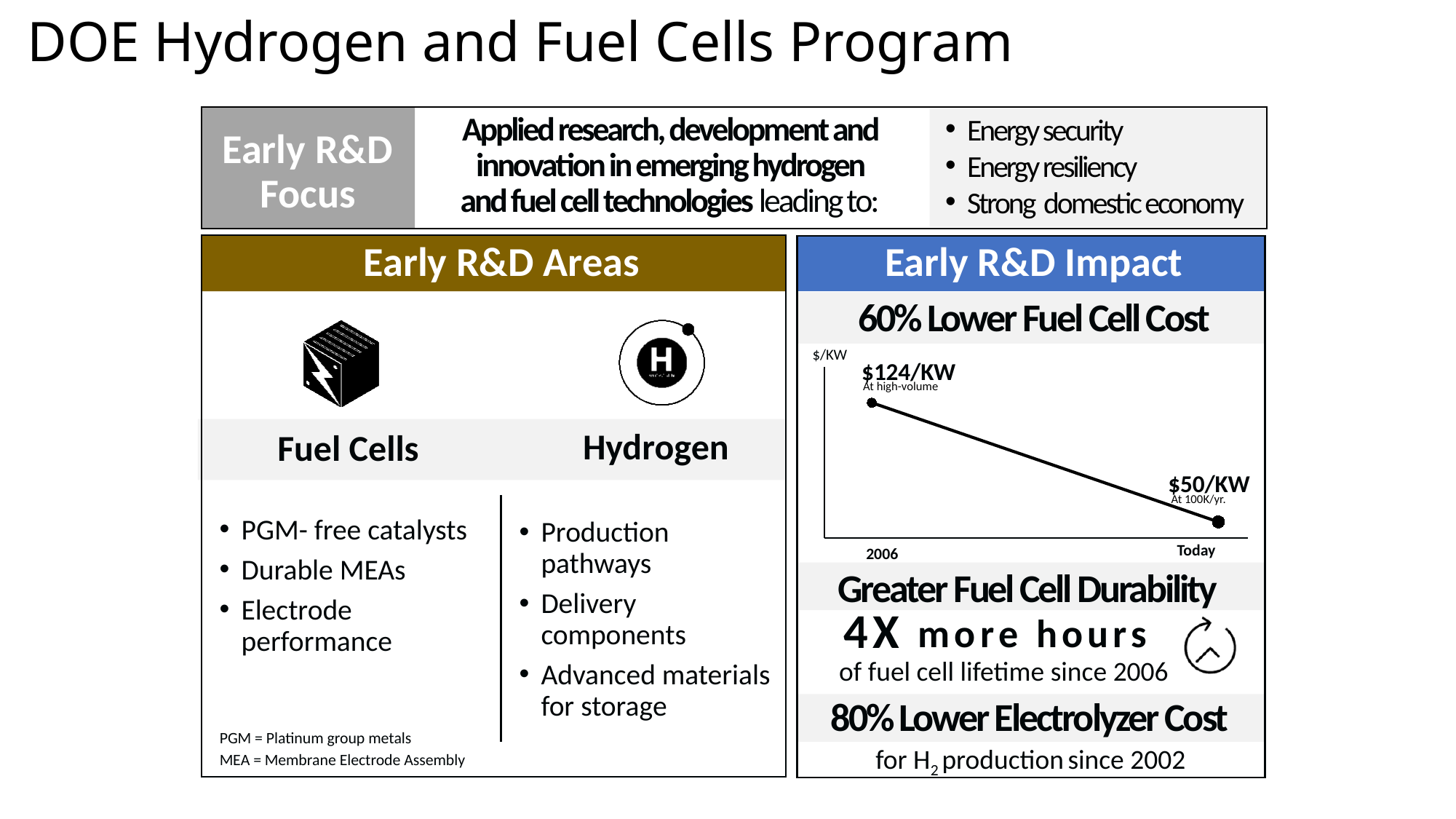
Does the fuel cell cost rise or fall from 2006 to Today in the chart? fall Which point on the chart has the higher fuel cell cost, 2006 or Today? 2006 What is the heading above the fuel cell cost chart? 60% Lower Fuel Cell Cost How many data points are plotted on the fuel cell cost chart? 2 What is the fuel cell cost shown for 2006 in the chart? $124/KW What production volume note is attached to the $50/KW point on the chart? At 100K/yr. By how much did the fuel cell cost per KW fall from 2006 to Today according to the chart? $74/KW What is the fuel cell cost shown for Today in the chart? $50/KW What is the unit label on the vertical axis of the fuel cell cost chart? $/KW Is the fuel cell cost for 2006 larger or smaller than the cost for Today? larger What kind of chart is used to show the fuel cell cost change? line chart Which point on the chart has the lower fuel cell cost, 2006 or Today? Today